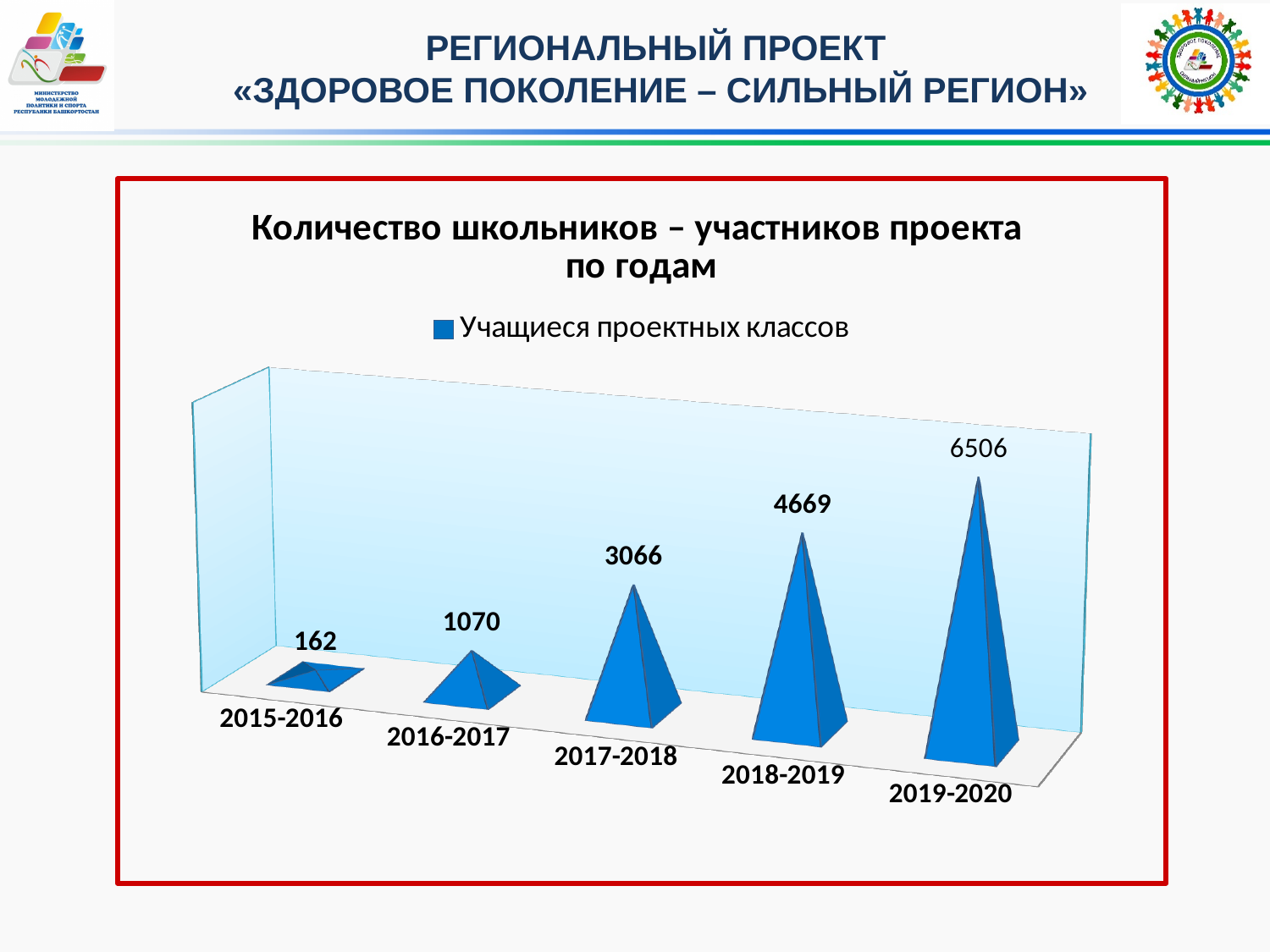
What is the difference between the values for 2019-2020 and 2018-2019? 1837 What is the value for 2017-2018? 3066 What is the value for 2019-2020? 6506 Which is larger, the value for 2017-2018 or the value for 2018-2019? 2018-2019 Do the values rise or fall from 2015-2016 to 2019-2020? rise How many year categories are shown on the chart? 5 Which year has the lowest number of participants? 2015-2016 What kind of chart is this? bar chart How many series does the legend list? 1 What is the difference between the values for 2016-2017 and 2015-2016? 908 What is the value for 2015-2016? 162 Which year has the highest number of participants? 2019-2020